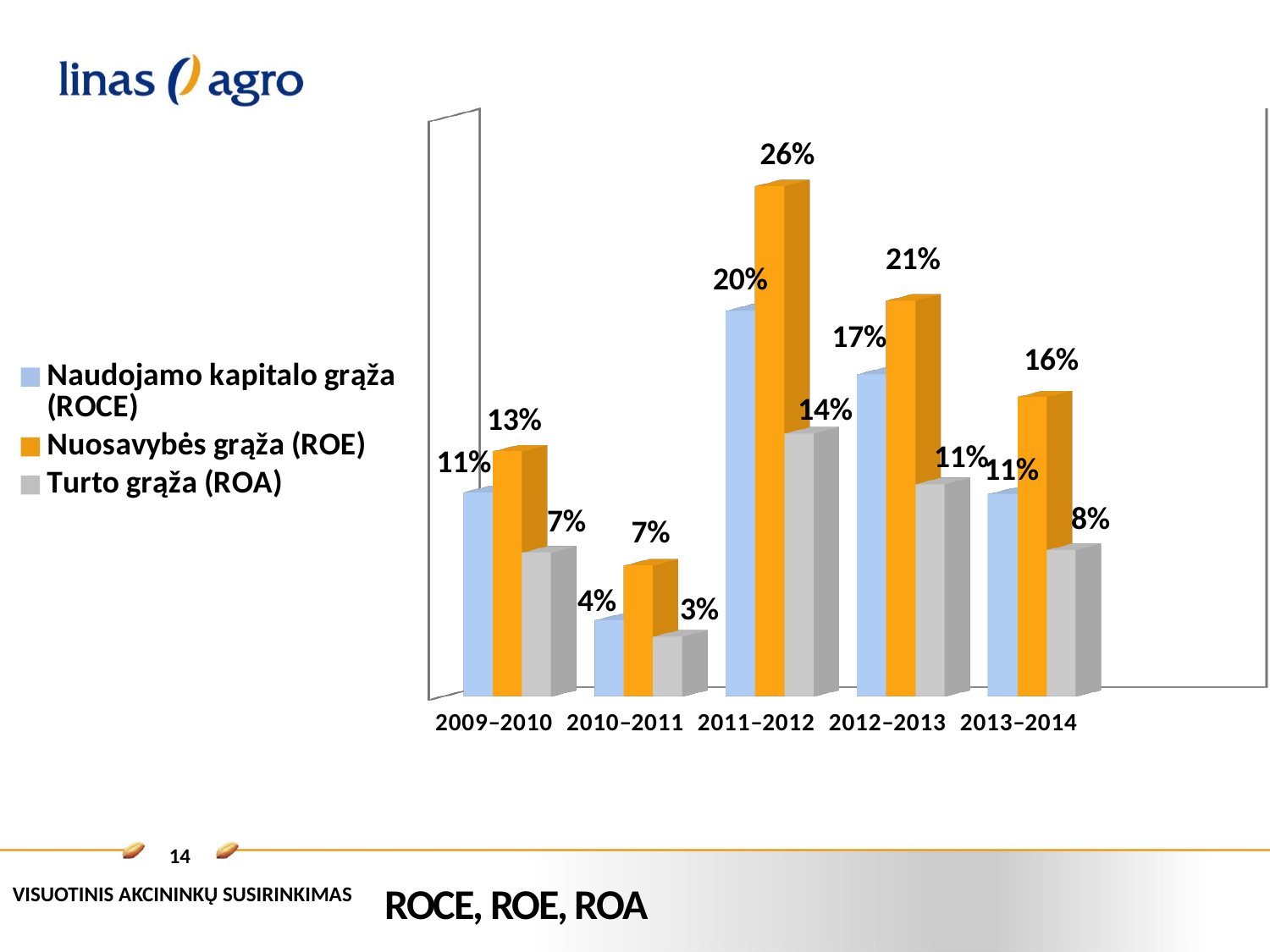
How many series does the legend list? 3 Which is larger: ROE in 2012–2013 or ROE in 2013–2014? ROE in 2012–2013 How many periods are shown on the x axis? 5 What is the ROCE (Naudojamo kapitalo grąža) value for 2013–2014? 11% What kind of chart is shown on the slide? Bar chart What is the ROE (Nuosavybės grąža) value for 2011–2012? 26% In which period is ROCE (Naudojamo kapitalo grąža) lowest? 2010–2011 What is the difference between ROA in 2011–2012 and ROA in 2013–2014? 6% What is the ROA (Turto grąža) value for 2010–2011? 3% In which period is ROE (Nuosavybės grąža) highest? 2011–2012 What is the ROCE (Naudojamo kapitalo grąža) value for 2012–2013? 17% What is the difference between ROE and ROCE in 2011–2012? 6%